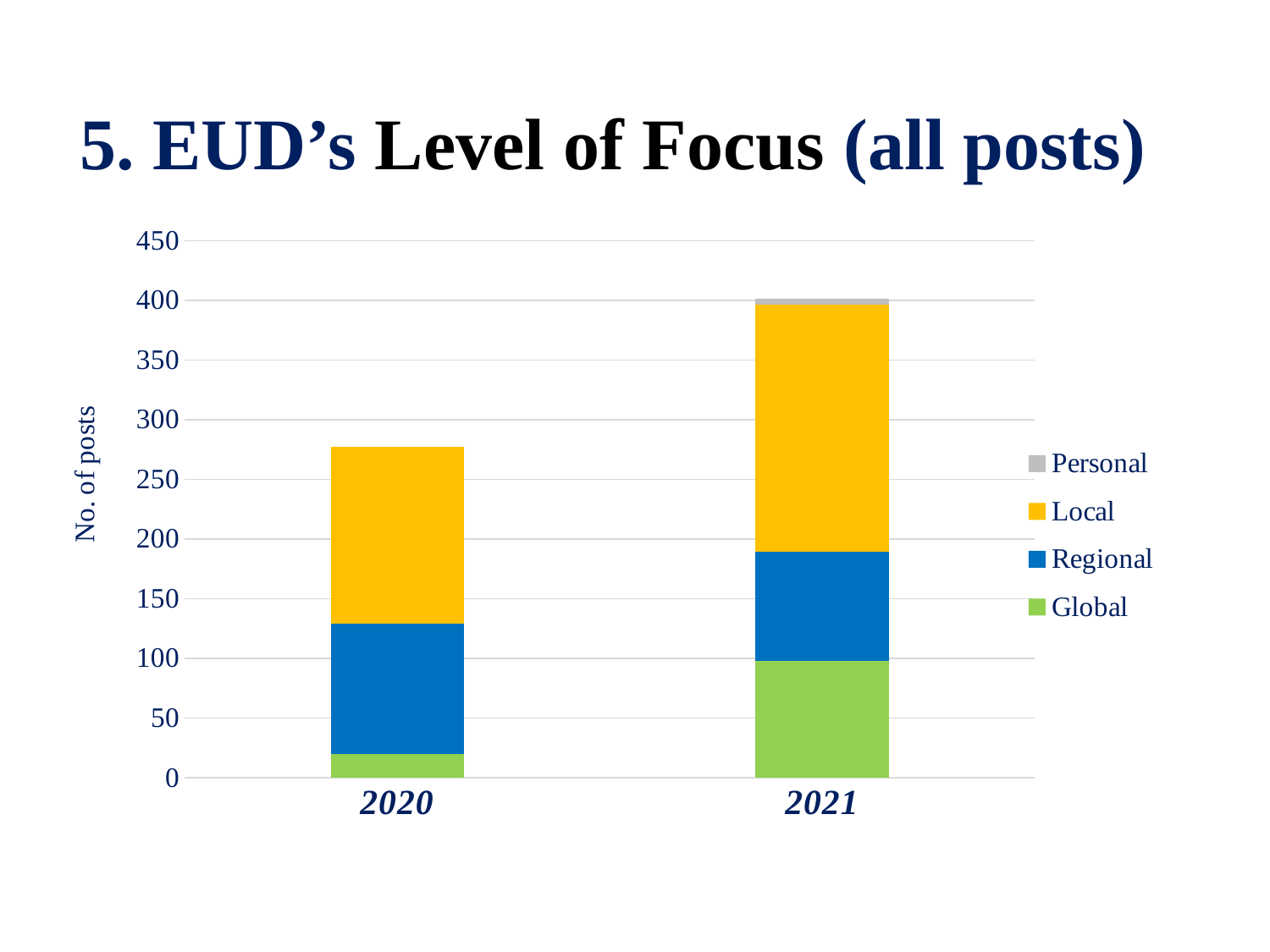
Which year has the highest total number of posts? 2021 Which series is shown in green in the legend? Global Which year has the lowest total number of posts? 2020 How many series does the legend list? 4 What kind of chart is shown on the slide? Stacked bar chart Is the Global value for 2020 greater or less than 50? less Which year has the taller stacked bar, 2020 or 2021? 2021 What is the label on the vertical axis? No. of posts Is the total number of posts for 2021 greater or less than 350? greater Is the total number of posts for 2020 greater or less than 300? less How many years (categories) are shown on the x axis? 2 Does the total number of posts rise or fall from 2020 to 2021? rise